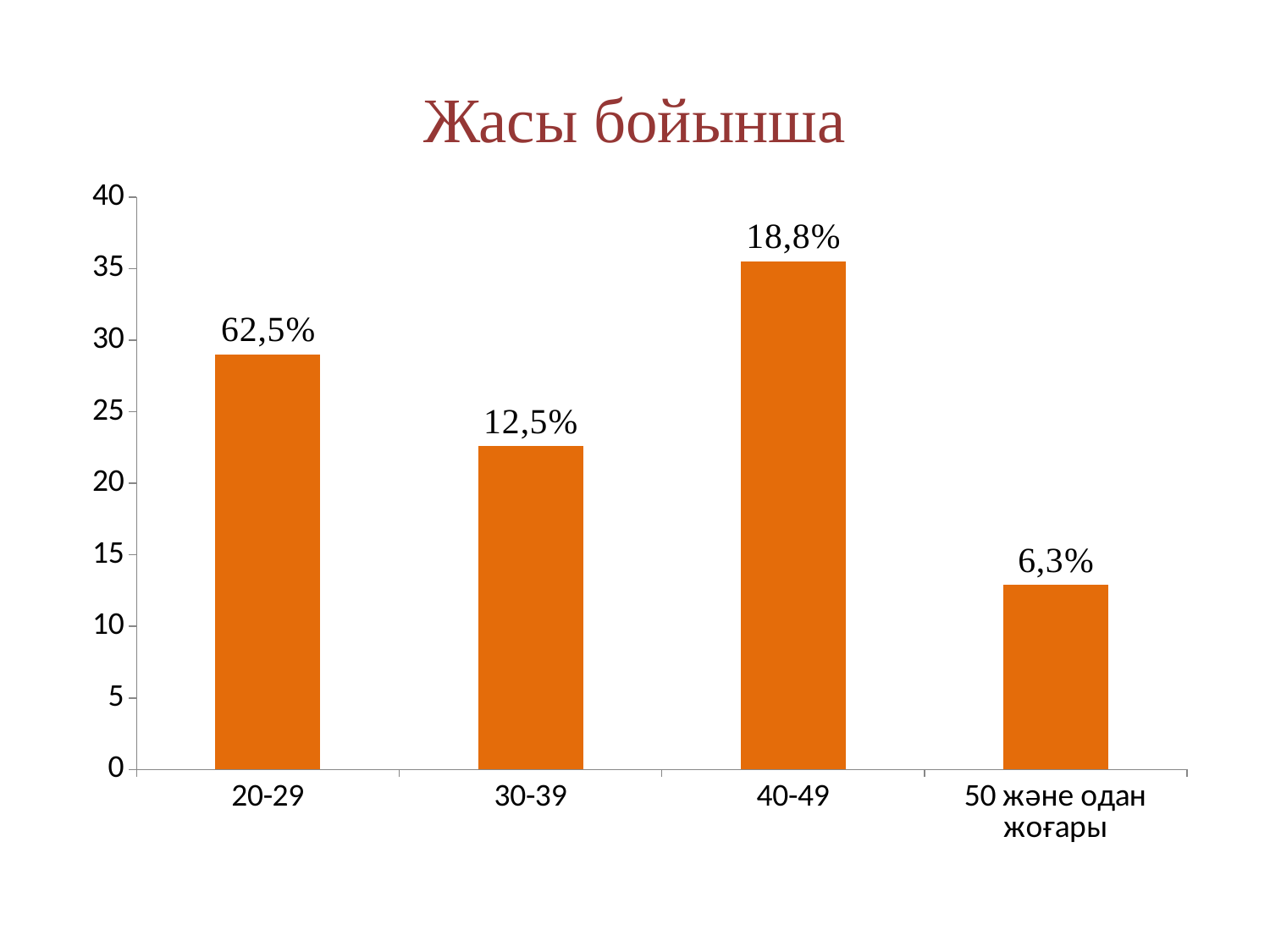
How many age groups are shown on the x axis? 4 What is the difference between the percentage labels for 20-29 and 30-39? 50,0% What percentage label is shown for the 20-29 age group? 62,5% What percentage label is shown for the '50 және одан жоғары' age group? 6,3% Which age group has the highest percentage label? 20-29 Which age group has the lowest percentage label? 50 және одан жоғары Which has the larger percentage label, 40-49 or 30-39? 40-49 What percentage label is shown for the 30-39 age group? 12,5% What kind of chart is shown on the slide? bar chart What is the title of the chart? Жасы бойынша What percentage label is shown for the 40-49 age group? 18,8% Is the bar for 40-49 greater or less than 30 on the vertical axis? greater